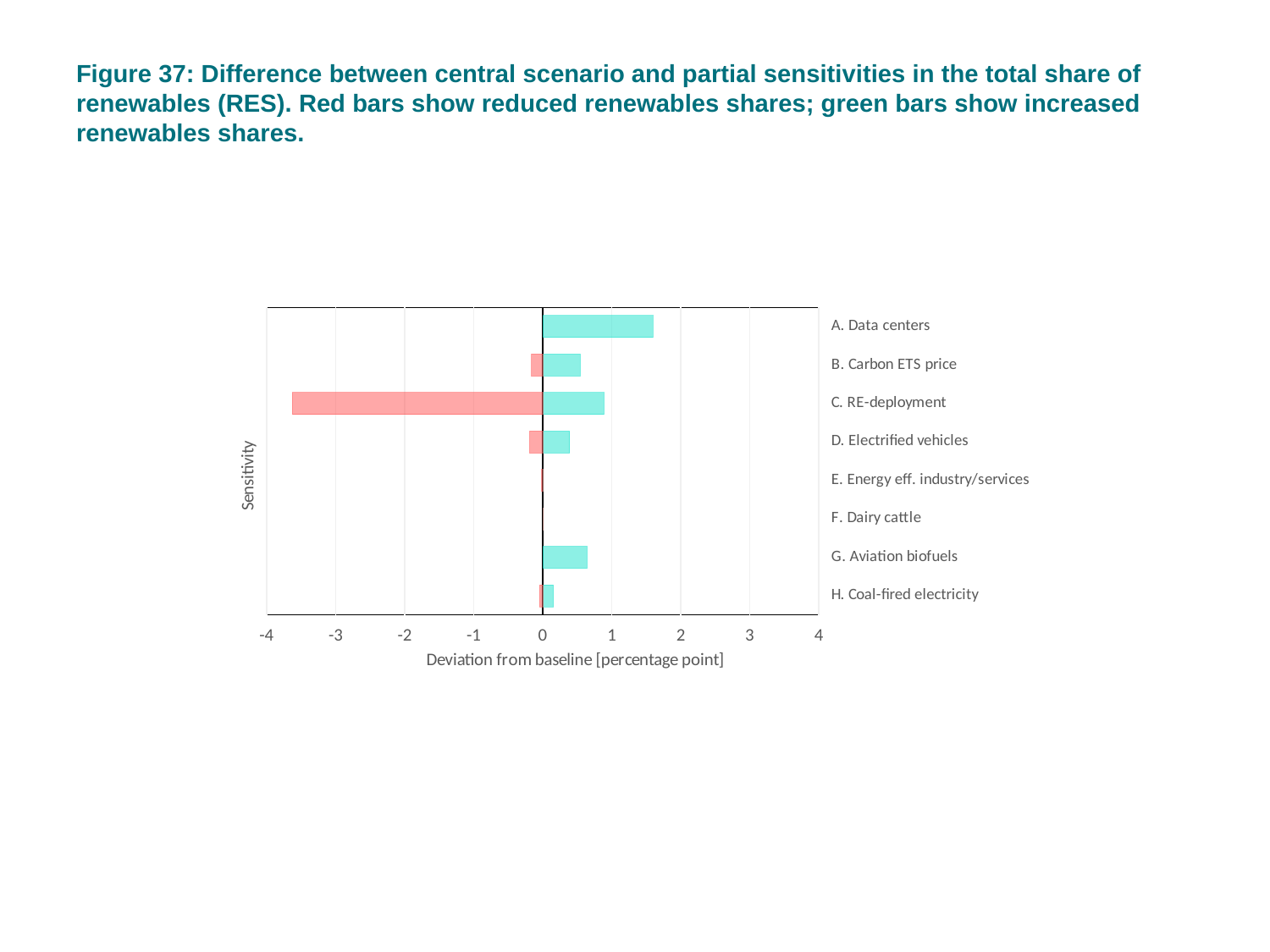
Is the red bar for C. RE-deployment greater or less than -3 percentage points? less Which sensitivity has the largest negative deviation (longest red bar)? C. RE-deployment Is the green bar for C. RE-deployment greater or less than 0? greater What is the label of the horizontal axis? Deviation from baseline [percentage point] What is the label of the vertical axis? Sensitivity What kind of chart is shown on the slide? bar chart How many sensitivity categories are listed on the chart? 8 Which has the longer red bar, C. RE-deployment or D. Electrified vehicles? C. RE-deployment Which has the longer green bar, A. Data centers or G. Aviation biofuels? A. Data centers Which sensitivity has the largest positive deviation (longest green bar)? A. Data centers Is the green bar for A. Data centers greater or less than 1 percentage point? greater